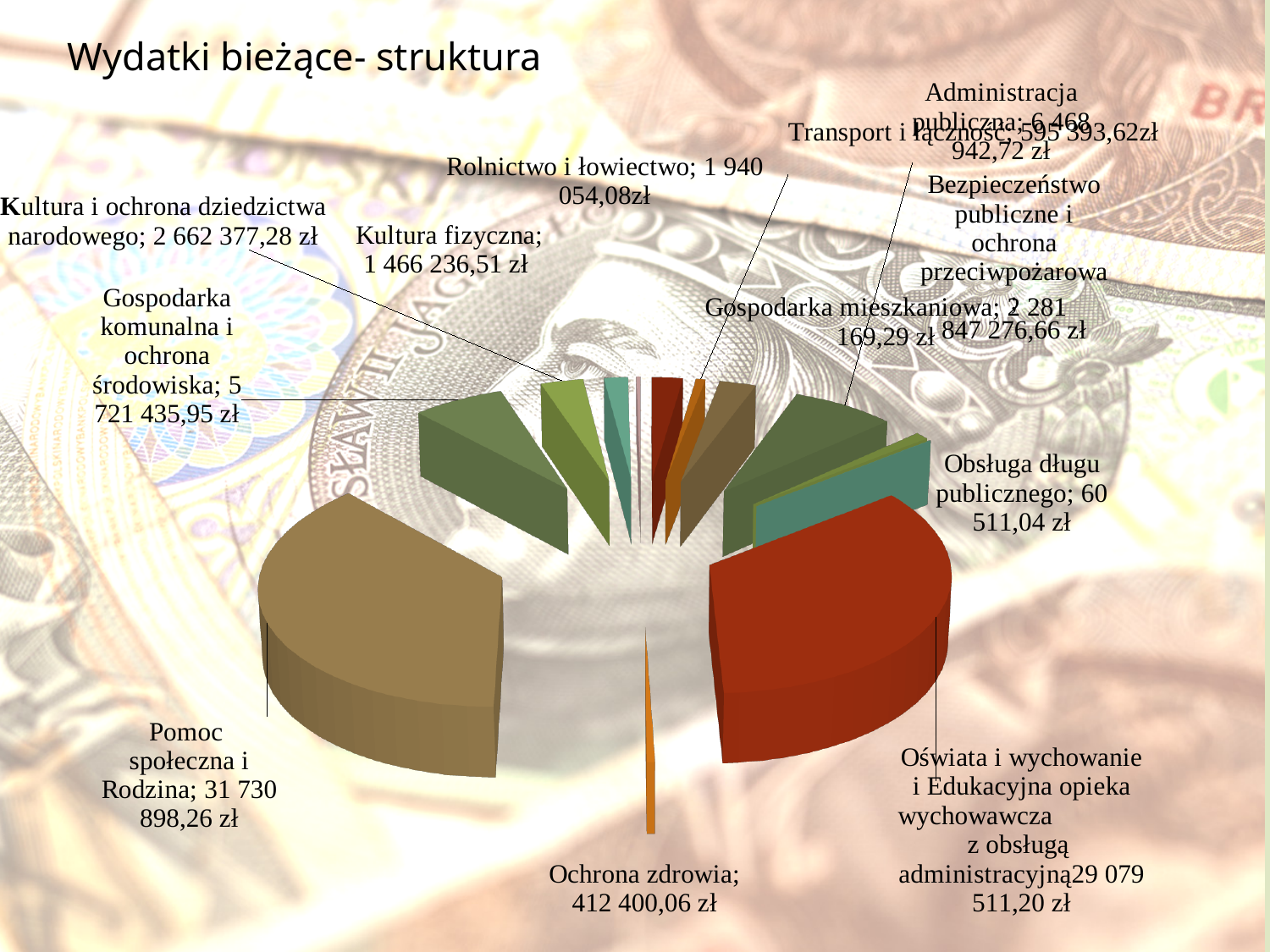
Which category has the smallest value? Obsługa długu publicznego Which is larger: Kultura i ochrona dziedzictwa narodowego or Rolnictwo i łowiectwo? Kultura i ochrona dziedzictwa narodowego What is the title of the chart? Wydatki bieżące- struktura What is the value for Ochrona zdrowia? 412 400,06 zł What kind of chart is shown on the slide? pie chart What is the value for Kultura fizyczna? 1 466 236,51 zł What is the value for Gospodarka komunalna i ochrona środowiska? 5 721 435,95 zł Which category has the largest value? Pomoc społeczna i Rodzina What is the value for Obsługa długu publicznego? 60 511,04 zł What is the difference between Pomoc społeczna i Rodzina and Oświata i wychowanie i Edukacyjna opieka wychowawcza z obsługą administracyjną? 2 651 387,06 zł What is the value for Pomoc społeczna i Rodzina? 31 730 898,26 zł What is the value for Gospodarka mieszkaniowa? 2 281 169,29 zł